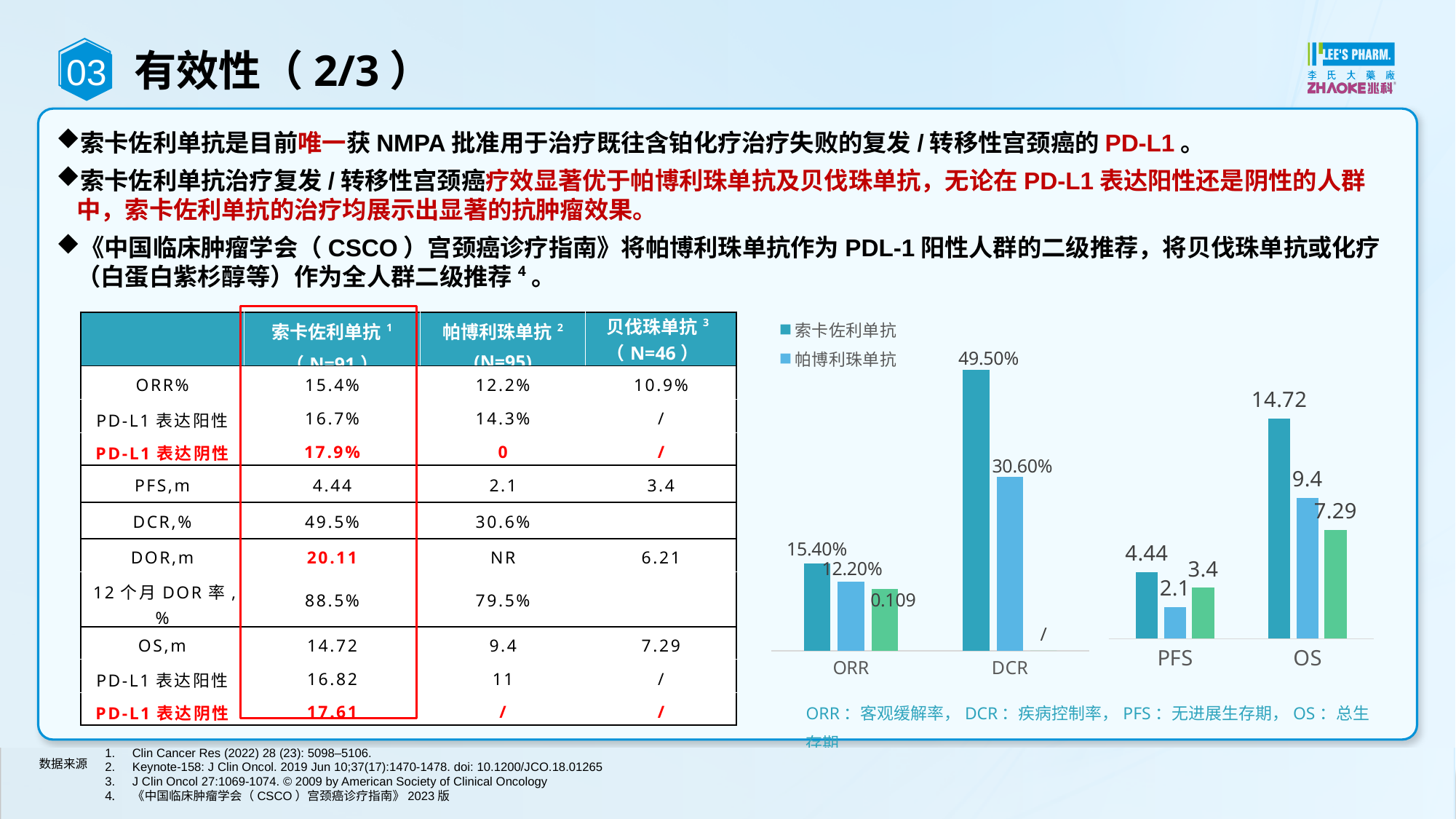
What is the PFS value for 帕博利珠单抗 in the bar chart? 2.1 What is the DCR value for 索卡佐利单抗 in the bar chart? 49.50% What is the OS value for 索卡佐利单抗 in the bar chart? 14.72 How many categories are shown on the x axis of the bar chart? 4 What is the OS value for 帕博利珠单抗 in the bar chart? 9.4 In the bar chart, for OS, which is larger: 索卡佐利单抗 or 帕博利珠单抗? 索卡佐利单抗 What kind of chart is shown on the right side of the slide? Bar chart In the bar chart, which category has the tallest bar for 索卡佐利单抗? DCR In the bar chart, what is the difference between the OS values of 索卡佐利单抗 and 帕博利珠单抗? 5.32 In the bar chart, what is the difference between the PFS values of 索卡佐利单抗 and 帕博利珠单抗? 2.34 What is the ORR value for 索卡佐利单抗 in the bar chart? 15.40% In the bar chart, what is the difference between the DCR values of 索卡佐利单抗 and 帕博利珠单抗? 18.90%